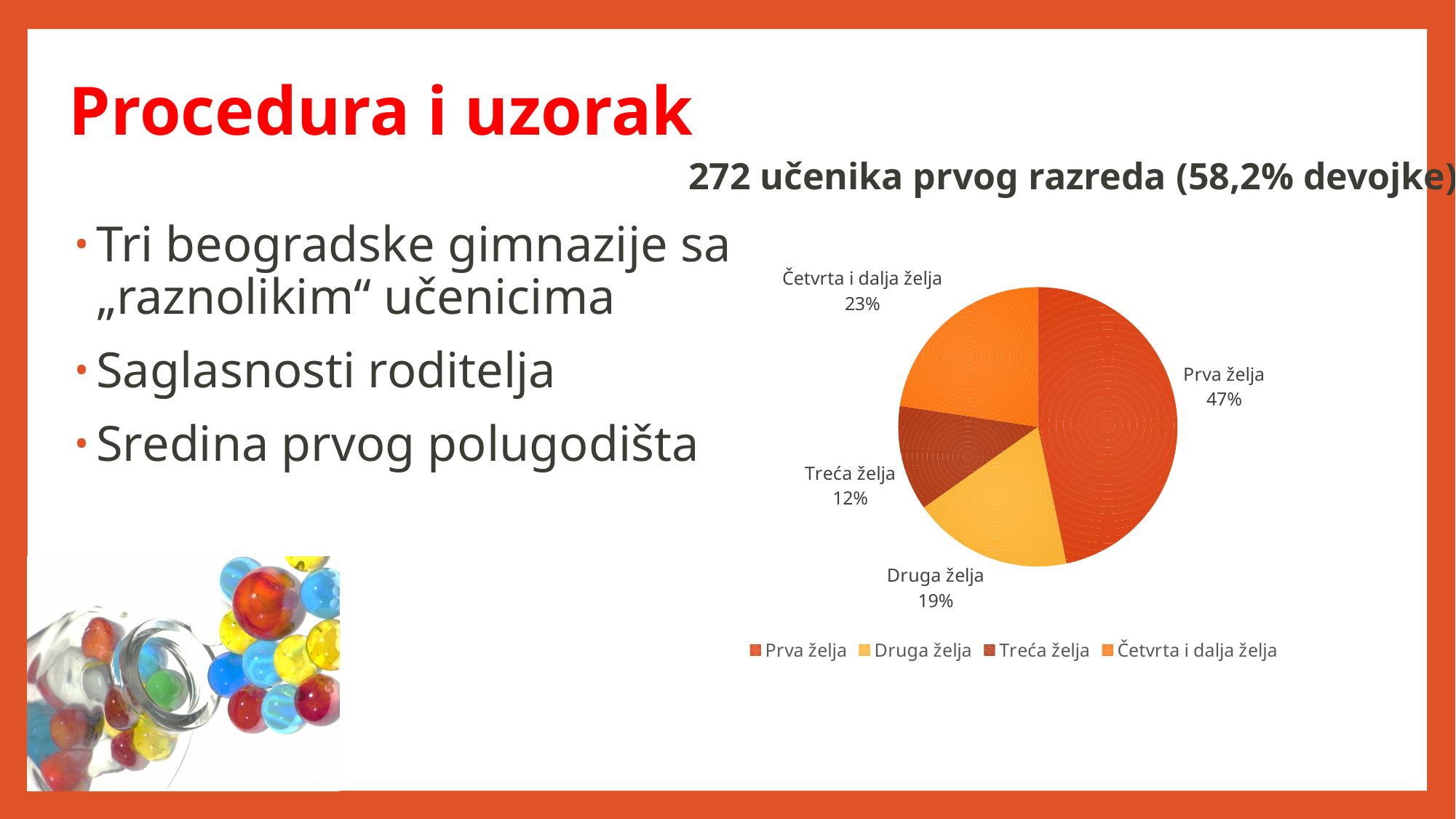
Which slice of the pie is the smallest? Treća želja What kind of chart is shown on the slide? pie chart Which slice of the pie is the largest? Prva želja How many entries does the legend of the pie chart list? 4 What share of the pie does "Prva želja" have? 47% What is the difference in percentage points between "Prva želja" and "Druga želja"? 28 Which is larger, the share for "Četvrta i dalja želja" or the share for "Druga želja"? Četvrta i dalja želja What share of the pie does "Četvrta i dalja želja" have? 23% How many slices does the pie chart have? 4 What share of the pie does "Treća želja" have? 12% Which legend entry is shown in yellow? Druga želja